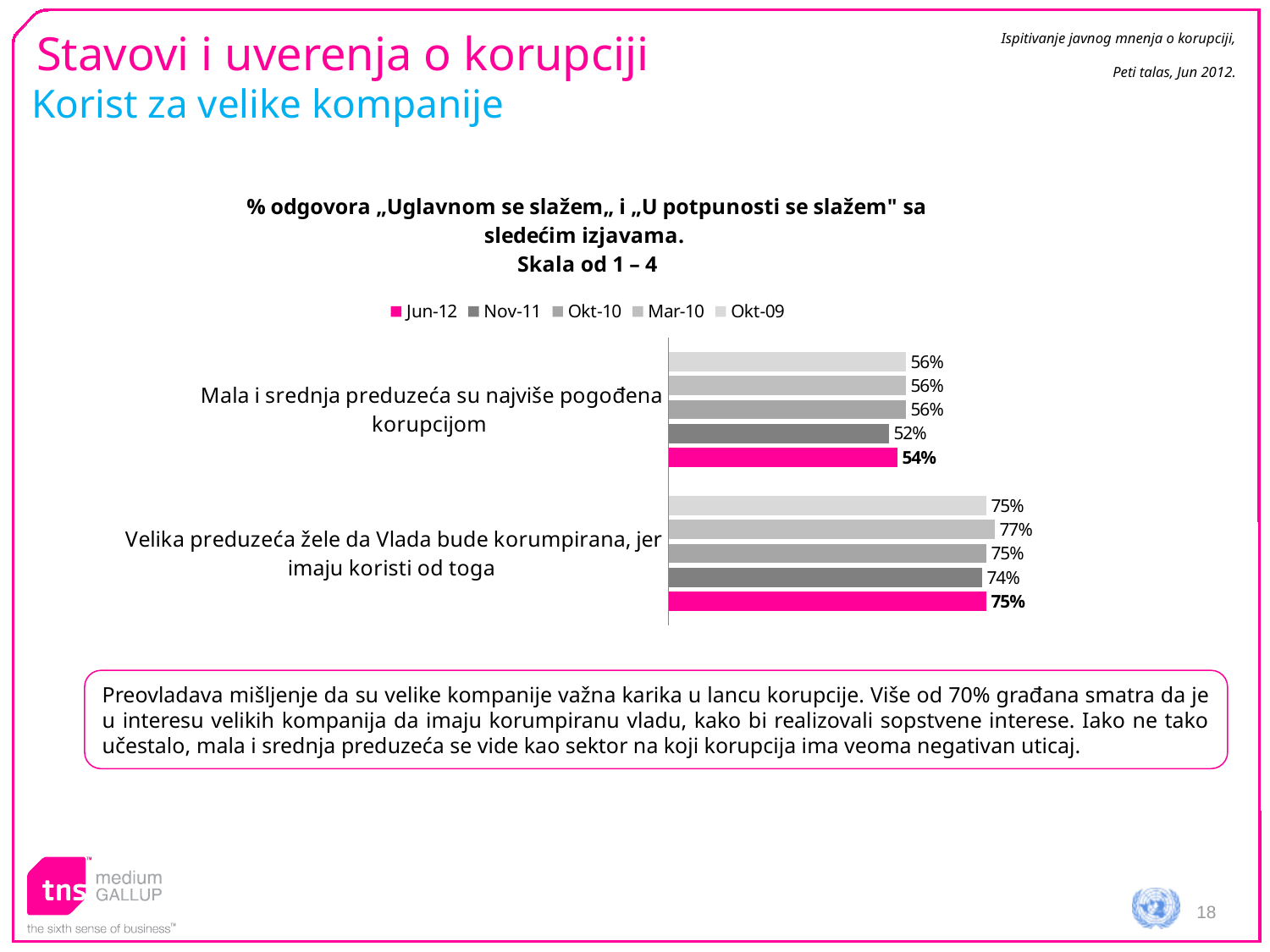
What is the Mar-10 value for "Velika preduzeća žele da Vlada bude korumpirana, jer imaju koristi od toga"? 77% How many statements (categories) are plotted in the chart? 2 What is the Jun-12 value for "Mala i srednja preduzeća su najviše pogođena korupcijom"? 54% Which series is shown in pink in the chart? Jun-12 What is the difference between the Jun-12 values for the two statements? 21% What is the Jun-12 value for "Velika preduzeća žele da Vlada bude korumpirana, jer imaju koristi od toga"? 75% What is the Nov-11 value for "Mala i srednja preduzeća su najviše pogođena korupcijom"? 52% What is the Nov-11 value for "Velika preduzeća žele da Vlada bude korumpirana, jer imaju koristi od toga"? 74% What type of chart is shown on the slide? bar chart Which wave has the lowest value for "Mala i srednja preduzeća su najviše pogođena korupcijom"? Nov-11 How many series does the legend list? 5 Which statement has the higher Jun-12 value? Velika preduzeća žele da Vlada bude korumpirana, jer imaju koristi od toga